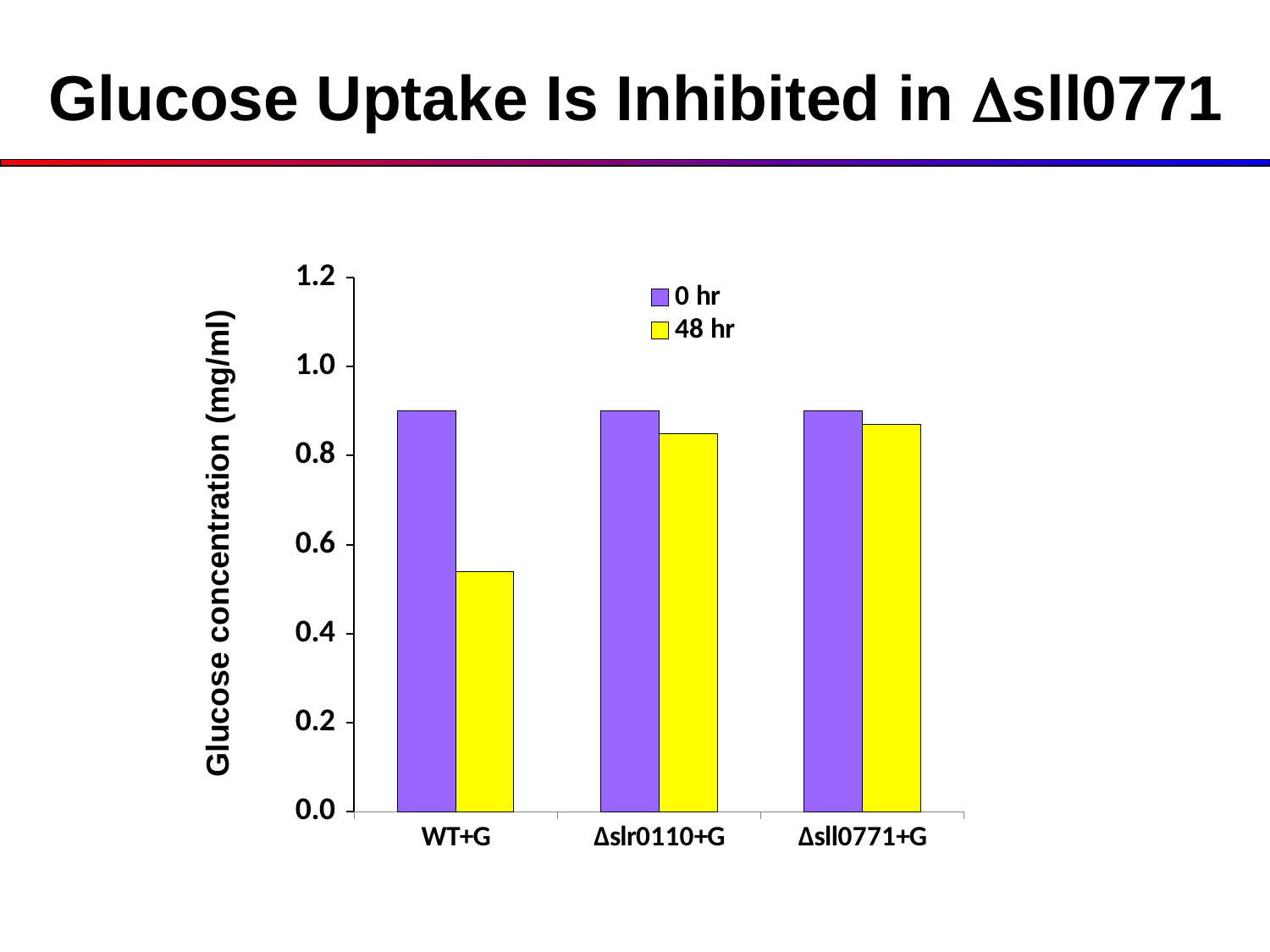
Which has the larger 48 hr value, WT+G or Δsll0771+G? Δsll0771+G Is the 48 hr value for WT+G greater or less than 0.6? less How many categories are shown on the x axis of the chart? 3 Which category has the lowest 48 hr value? WT+G For WT+G, which is larger, the 0 hr value or the 48 hr value? 0 hr What colour are the 48 hr bars in the chart? yellow How many series does the chart's legend list? 2 What kind of chart is shown on the slide? bar chart Is the 48 hr value for Δsll0771+G greater or less than 1.0? less What is the title of the y axis of the chart? Glucose concentration (mg/ml) Is the 0 hr value for WT+G greater or less than 0.8? greater